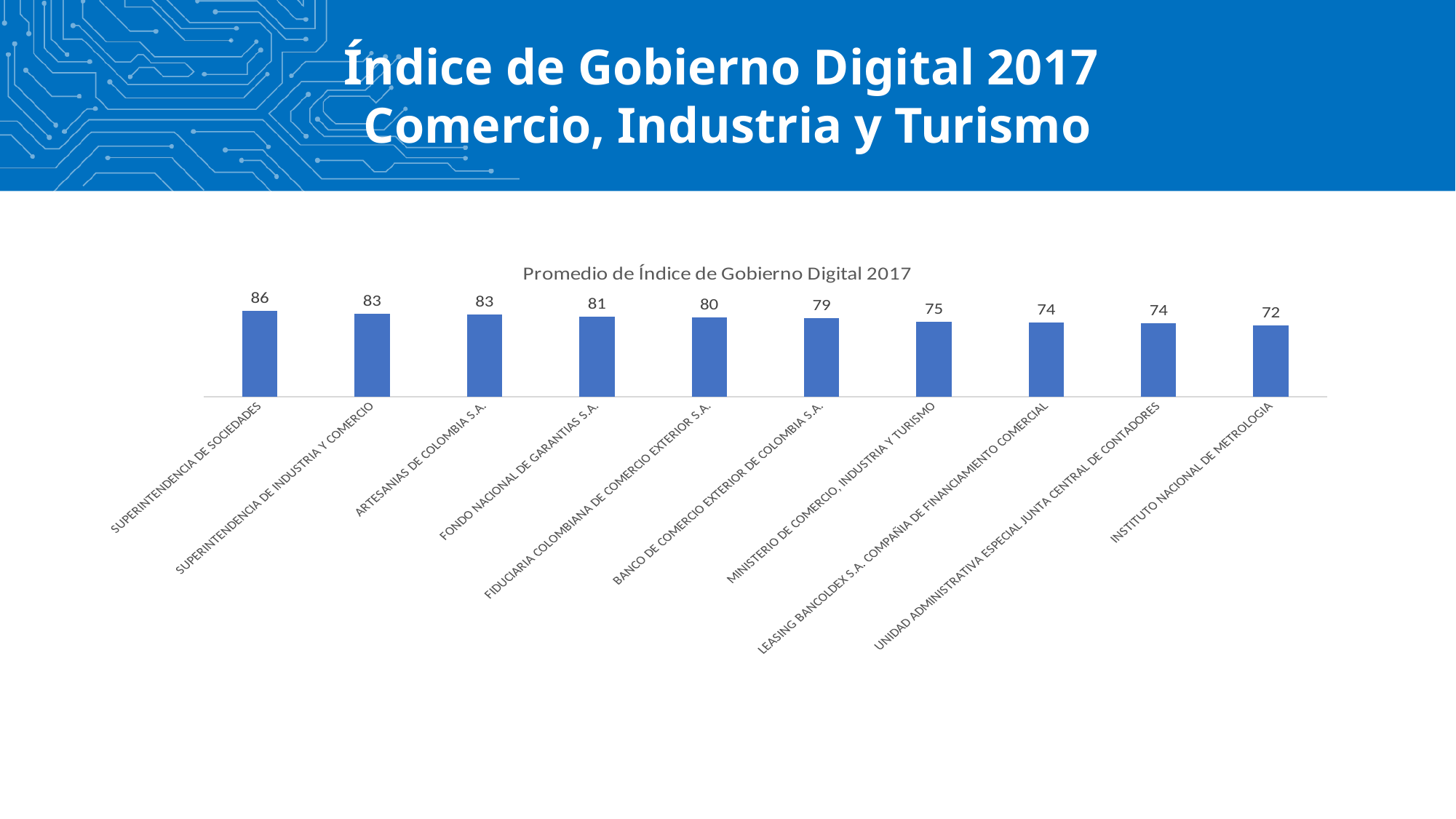
How many categories are shown in the chart? 10 Which category has the lowest value? INSTITUTO NACIONAL DE METROLOGIA What is the value for INSTITUTO NACIONAL DE METROLOGIA? 72 What kind of chart is shown on the slide? Bar chart What is the value for MINISTERIO DE COMERCIO, INDUSTRIA Y TURISMO? 75 What is the title of the chart? Promedio de Índice de Gobierno Digital 2017 Which category has the highest value? SUPERINTENDENCIA DE SOCIEDADES What is the value for SUPERINTENDENCIA DE SOCIEDADES? 86 Do the values rise or fall from left to right along the x axis? Fall What is the difference between the values for SUPERINTENDENCIA DE SOCIEDADES and INSTITUTO NACIONAL DE METROLOGIA? 14 What is the value for FONDO NACIONAL DE GARANTIAS S.A.? 81 Which is larger, the value for BANCO DE COMERCIO EXTERIOR DE COLOMBIA S.A. or the value for MINISTERIO DE COMERCIO, INDUSTRIA Y TURISMO? BANCO DE COMERCIO EXTERIOR DE COLOMBIA S.A.